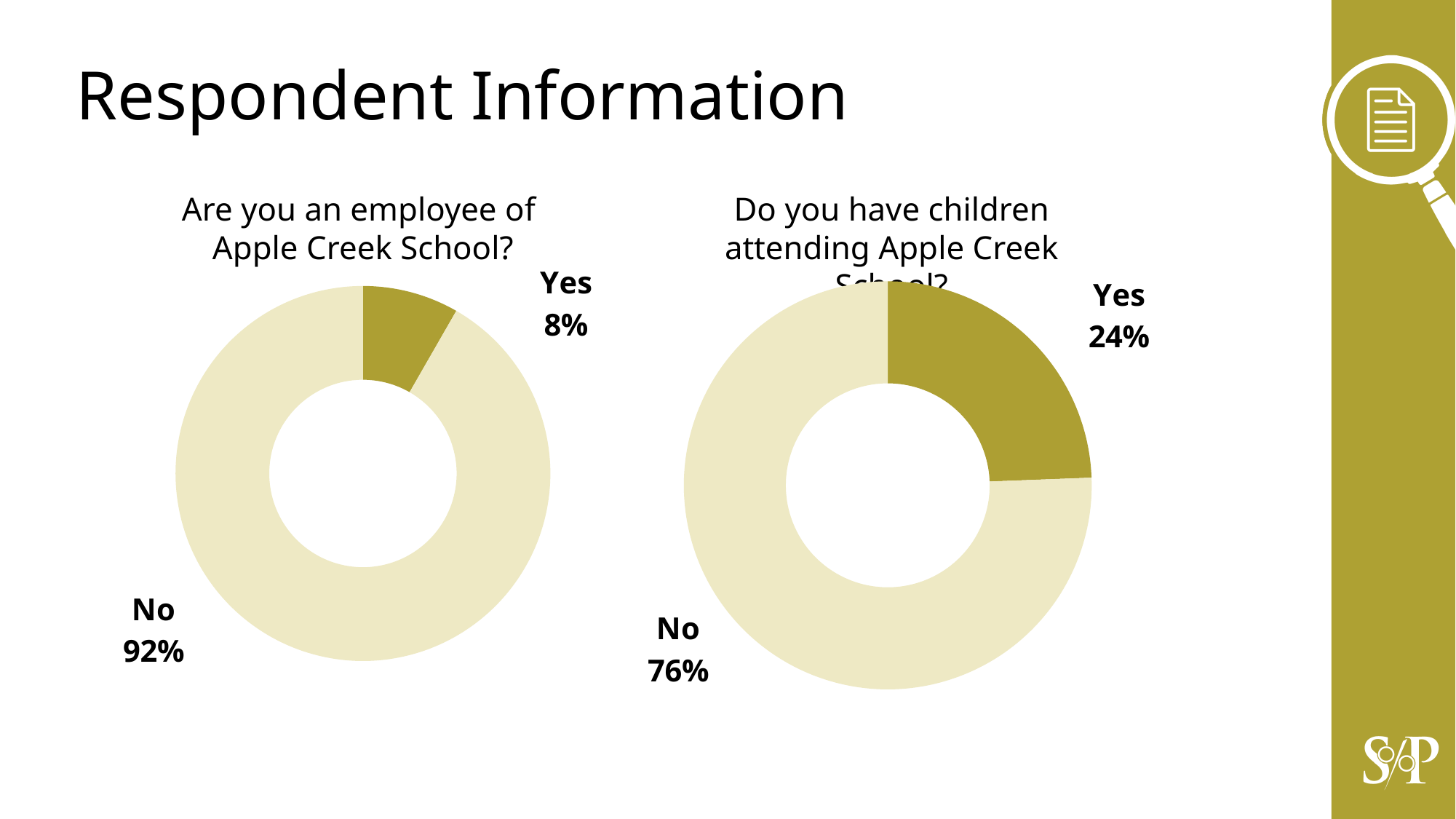
What is the title of the slide? Respondent Information In the right chart, what is the difference between the No and Yes shares? 52% Which is larger: the Yes share in the left chart or the Yes share in the right chart? The Yes share in the right chart In the left chart, which response has the largest share? No In the chart titled "Are you an employee of Apple Creek School?", what percentage of respondents answered No? 92% In the chart titled "Do you have children attending Apple Creek School?", what percentage of respondents answered Yes? 24% How many slices does the left chart have? 2 In the chart titled "Are you an employee of Apple Creek School?", what percentage of respondents answered Yes? 8% In the left chart, what is the difference between the No and Yes shares? 84% In the right chart, which response has the smallest share? Yes In the chart titled "Do you have children attending Apple Creek School?", what percentage of respondents answered No? 76% What type of chart is used on the right side of the slide? Doughnut chart